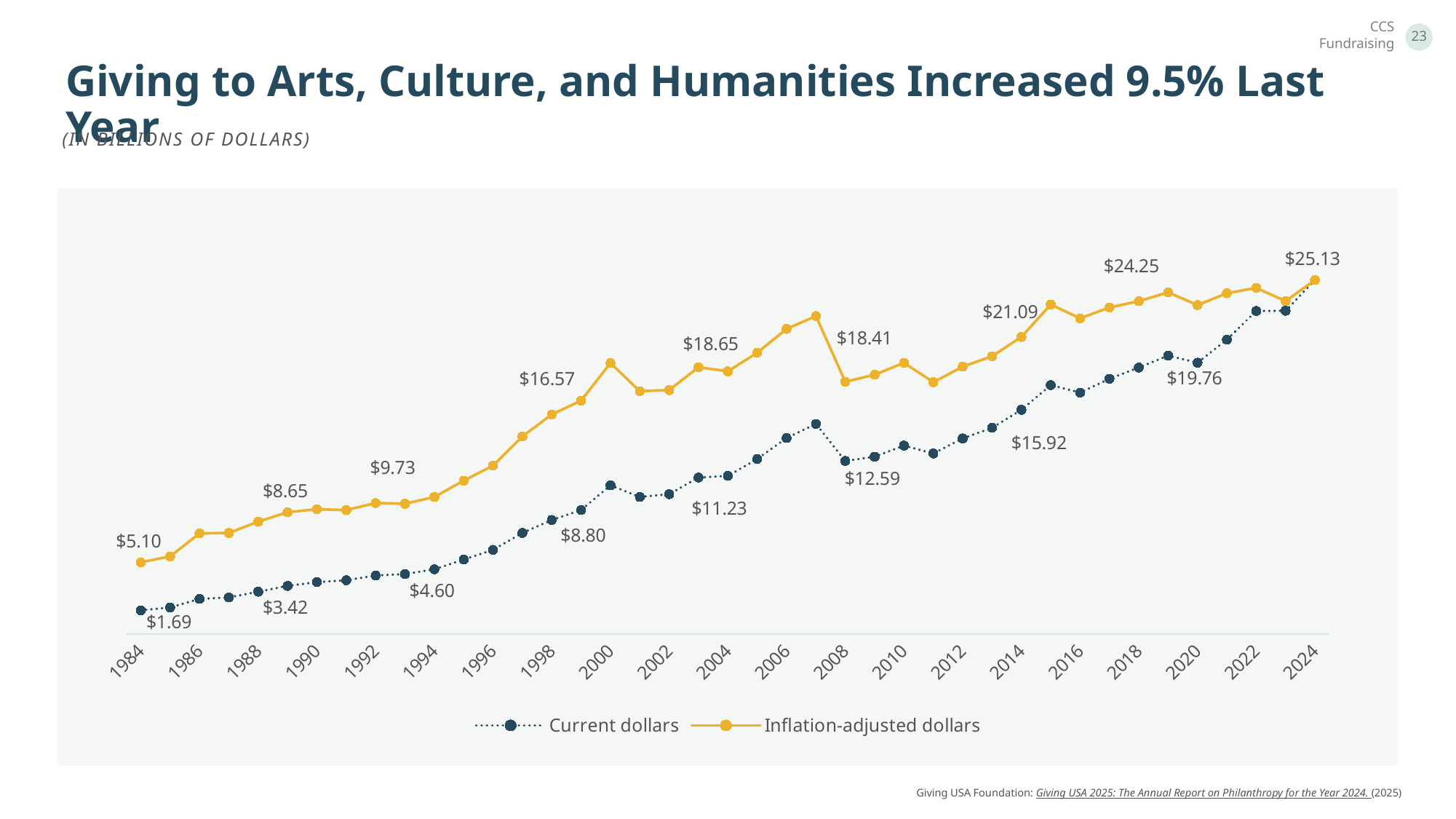
What kind of chart is shown on the slide? line chart What is the difference between the inflation-adjusted and current dollars values in 1984? $3.41 How many series does the legend list? 2 Which year has the highest inflation-adjusted dollars value? 2024 What is the current dollars value for 1984? $1.69 In 2000, which series has the higher value, current dollars or inflation-adjusted dollars? Inflation-adjusted dollars What is the inflation-adjusted dollars value for 1984? $5.10 What is the inflation-adjusted dollars value for 2024? $25.13 Which year has the lowest current dollars value? 1984